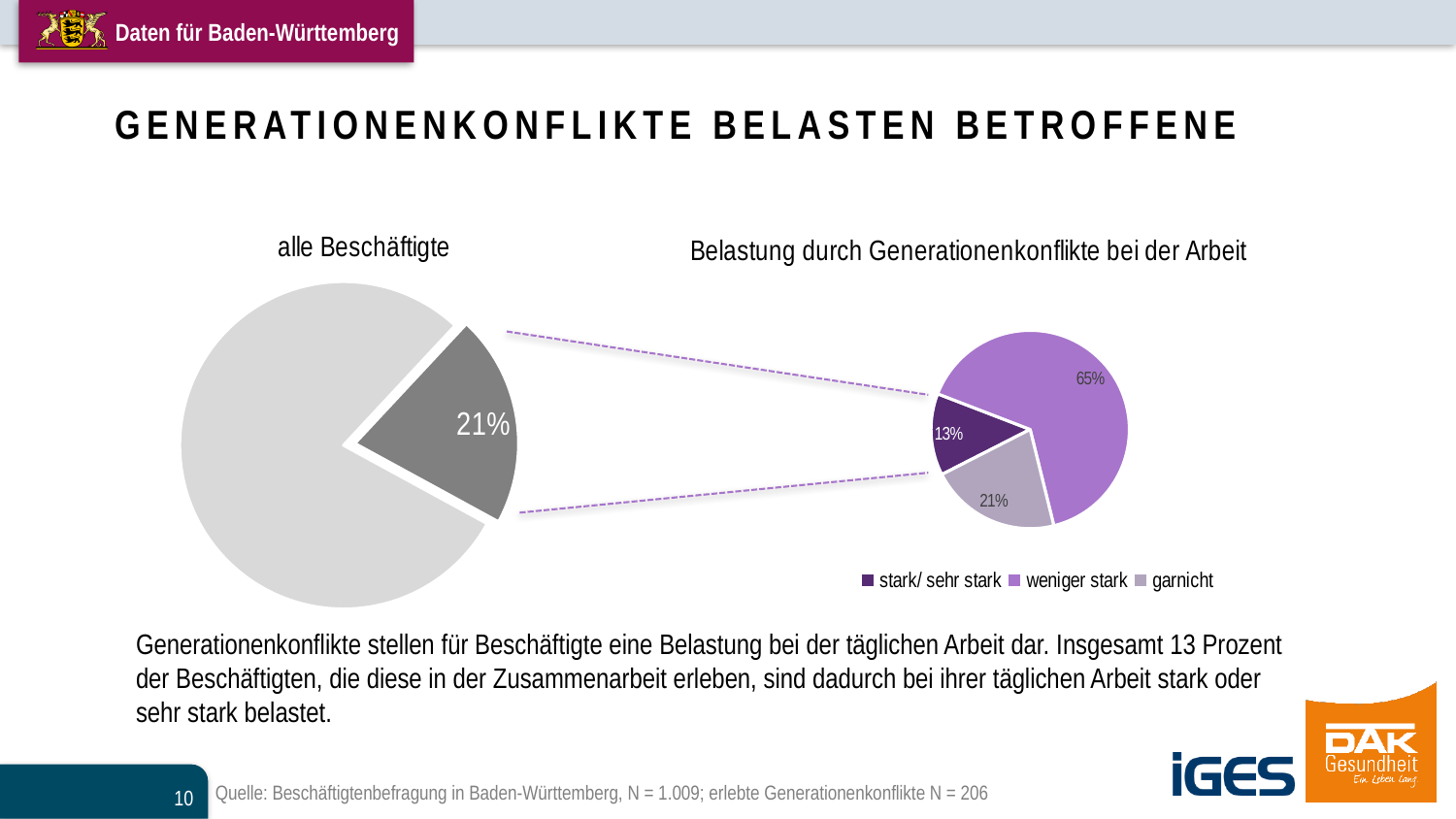
In the chart titled 'Belastung durch Generationenkonflikte bei der Arbeit', what share is labelled for 'weniger stark'? 65% In the chart titled 'Belastung durch Generationenkonflikte bei der Arbeit', what share is labelled for 'garnicht'? 21% What is the title of the chart on the right side of the slide? Belastung durch Generationenkonflikte bei der Arbeit How many slices does the chart titled 'Belastung durch Generationenkonflikte bei der Arbeit' have? 3 In the chart titled 'alle Beschäftigte', what percentage is printed on the highlighted dark slice? 21% In the chart titled 'Belastung durch Generationenkonflikte bei der Arbeit', what share is labelled for 'stark/ sehr stark'? 13% In the chart titled 'Belastung durch Generationenkonflikte bei der Arbeit', which category has the largest share? weniger stark What type of chart is the chart titled 'alle Beschäftigte'? pie chart In the chart titled 'Belastung durch Generationenkonflikte bei der Arbeit', what is the difference in percentage points between 'weniger stark' and 'garnicht'? 44 In the chart titled 'Belastung durch Generationenkonflikte bei der Arbeit', which is larger: the share for 'garnicht' or the share for 'stark/ sehr stark'? garnicht How many entries does the legend of the chart titled 'Belastung durch Generationenkonflikte bei der Arbeit' list? 3 In the chart titled 'Belastung durch Generationenkonflikte bei der Arbeit', which category has the smallest share? stark/ sehr stark